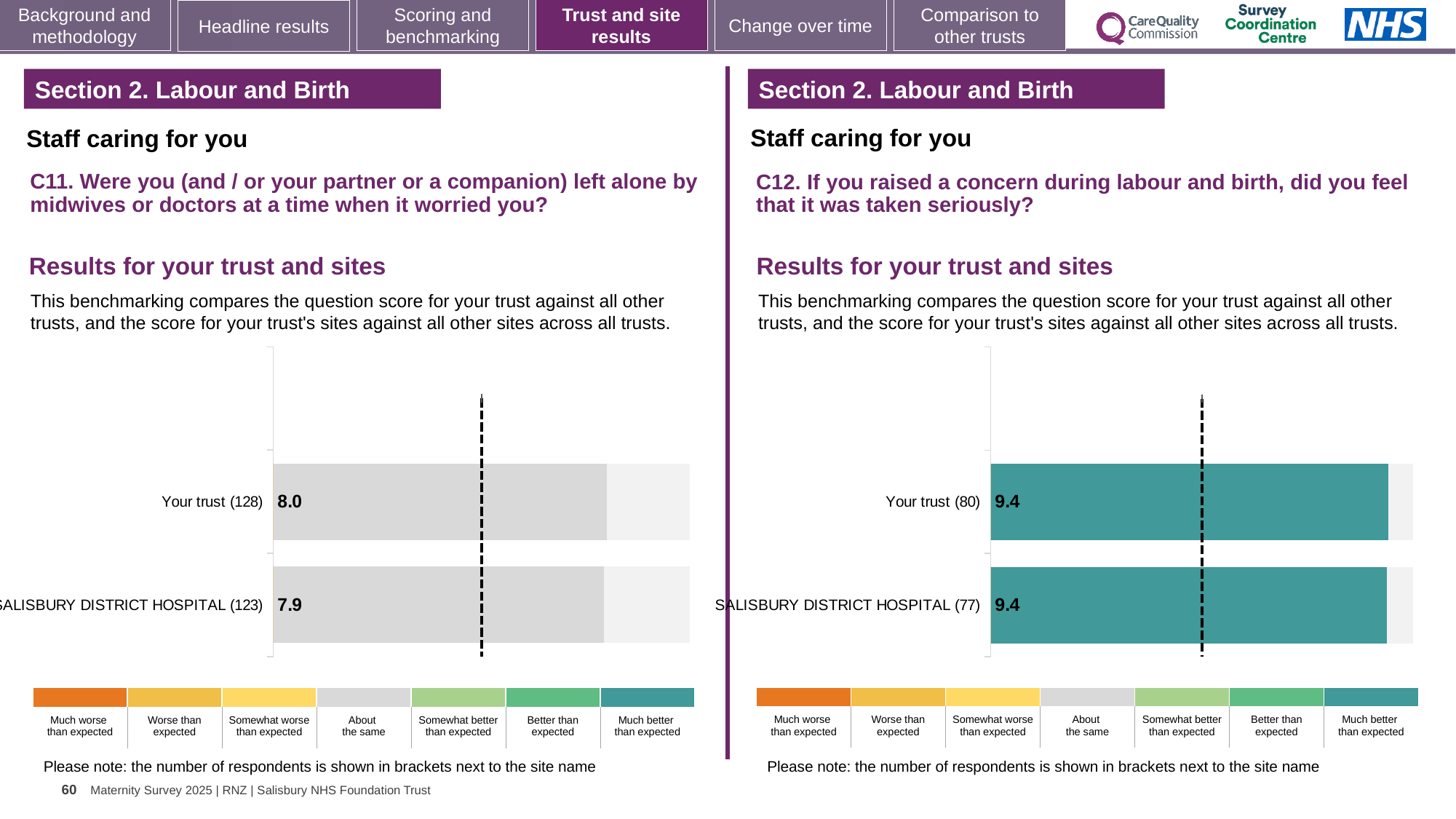
According to the colour legend, which benchmark category do the grey bars in the C11 chart on the left represent? About the same What type of chart is used in the C11 chart on the left? Bar chart In the C11 chart on the left, how many respondents are shown in brackets for Your trust? 128 In the C12 chart on the right, what is the score for Salisbury District Hospital? 9.4 In the C11 chart on the left, what is the difference between the Your trust score and the Salisbury District Hospital score? 0.1 How many bars are plotted in the C12 chart on the right? 2 According to the colour legend, which benchmark category do the teal bars in the C12 chart on the right represent? Much better than expected In the C11 chart on the left, what is the score for Your trust? 8.0 In the C11 chart on the left, what is the score for Salisbury District Hospital? 7.9 In the C11 chart on the left, which has the higher score: Your trust or Salisbury District Hospital? Your trust In the C12 chart on the right, how many respondents are shown in brackets for Salisbury District Hospital? 77 In the C12 chart on the right, what is the score for Your trust? 9.4